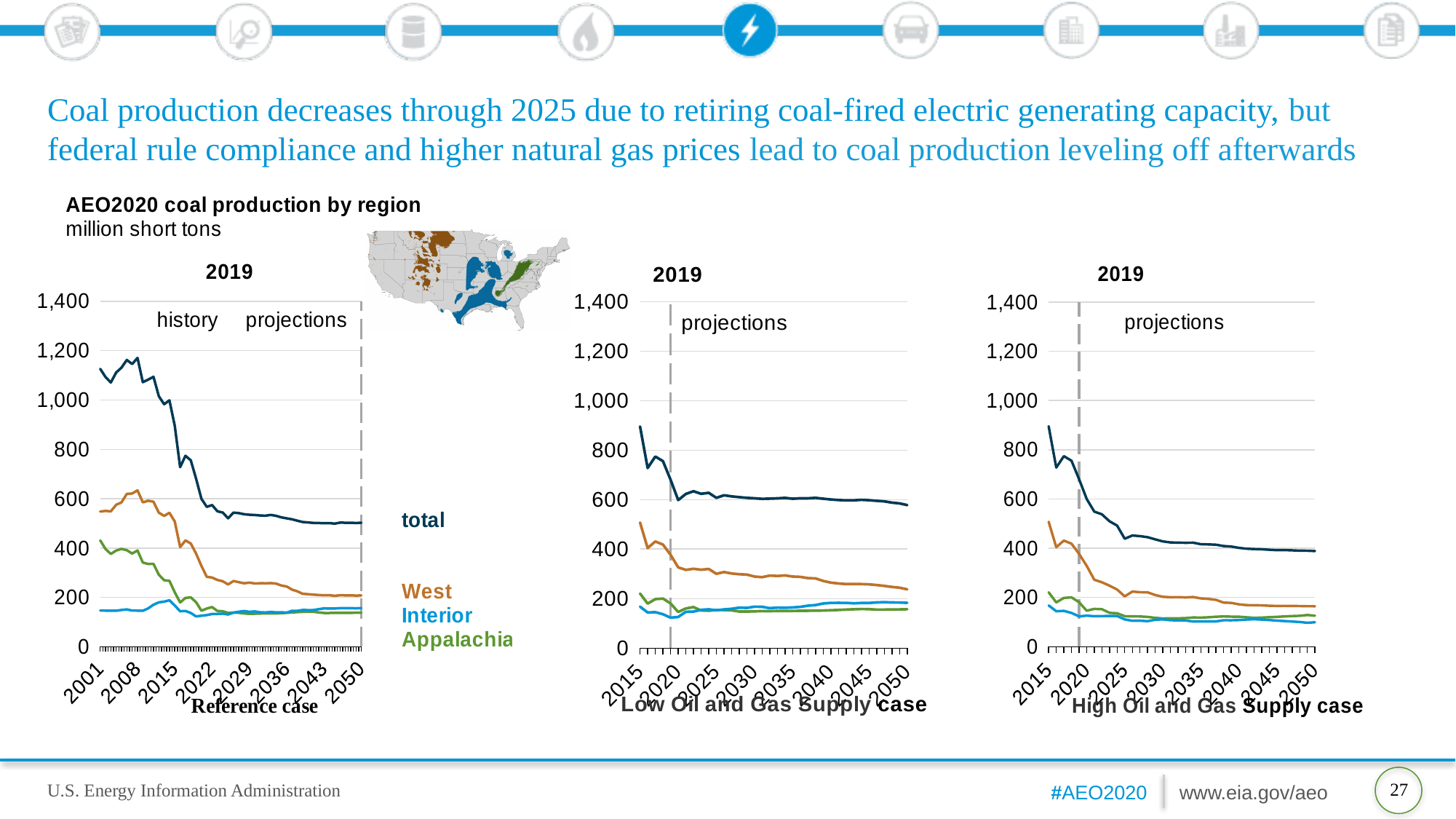
What is the title of the chart group on the slide? AEO2020 coal production by region Which chart shows a higher total in 2050, the Low Oil and Gas Supply case or the High Oil and Gas Supply case? Low Oil and Gas Supply case In the High Oil and Gas Supply case chart, is the value for West in 2050 greater or less than 200? less In the Low Oil and Gas Supply case chart, is the value for total in 2050 greater or less than 400? greater In the Reference case chart, is the value for total in 2050 greater or less than 400? greater What kind of chart is the Reference case chart? line chart How many series does the legend list for the coal production charts? 4 In what units are the coal production charts measured? million short tons In the Reference case chart, does the total rise or fall from 2001 to 2050? fall In the Reference case chart, which is larger in 2050, West or Appalachia? West